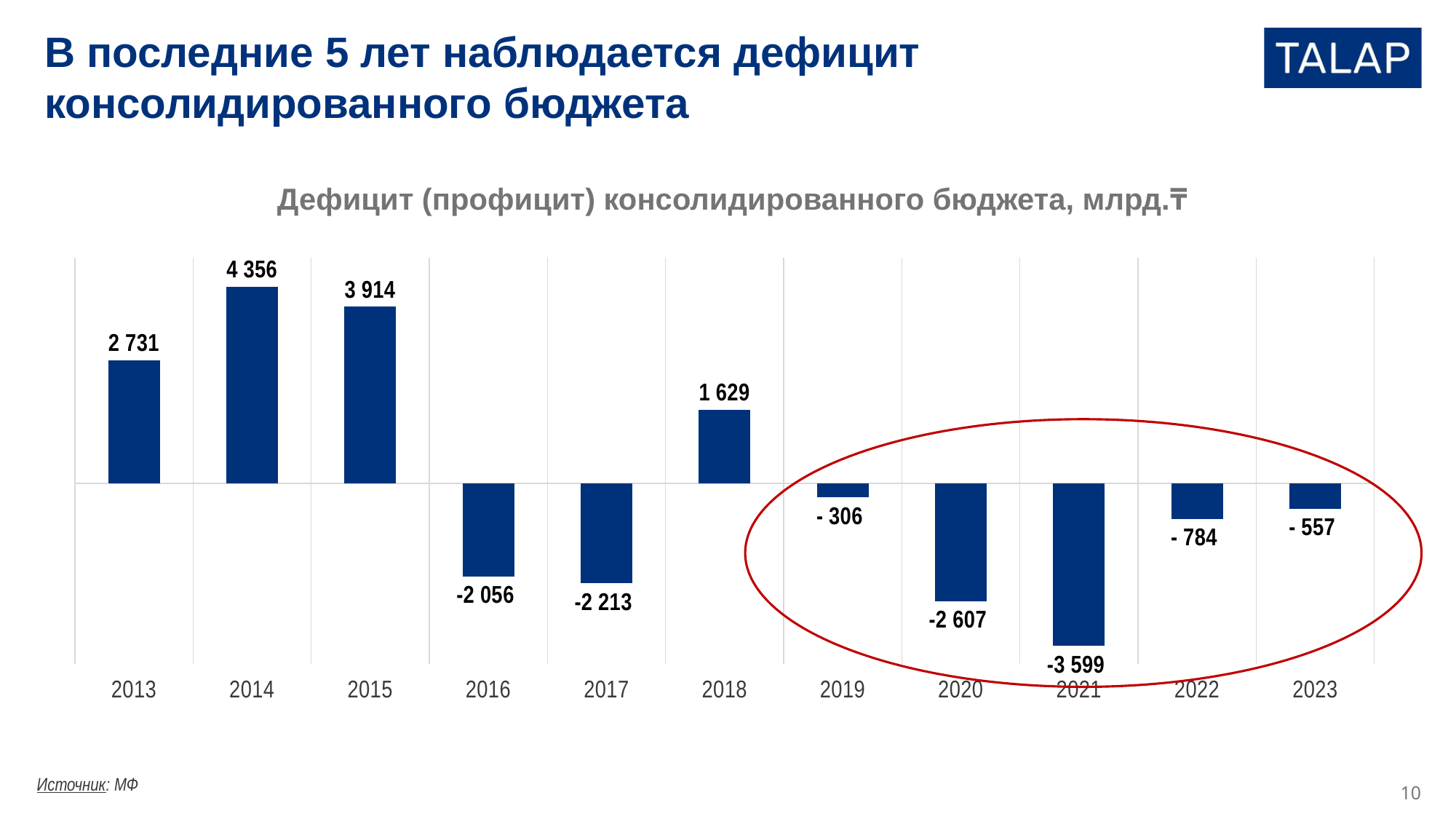
What is the value for 2021? -3 599 What is the value for 2014? 4 356 Which year has the lowest value? 2021 What is the difference between the values for 2013 and 2018? 1 102 Which is larger, the value for 2016 or the value for 2017? 2016 What is the value for 2019? - 306 Which year has the highest value? 2014 What is the title of the chart? Дефицит (профицит) консолидированного бюджета, млрд.₸ What is the value for 2018? 1 629 What kind of chart is shown on the slide? Bar chart How many years are shown on the x axis? 11 What is the difference between the values for 2014 and 2015? 442